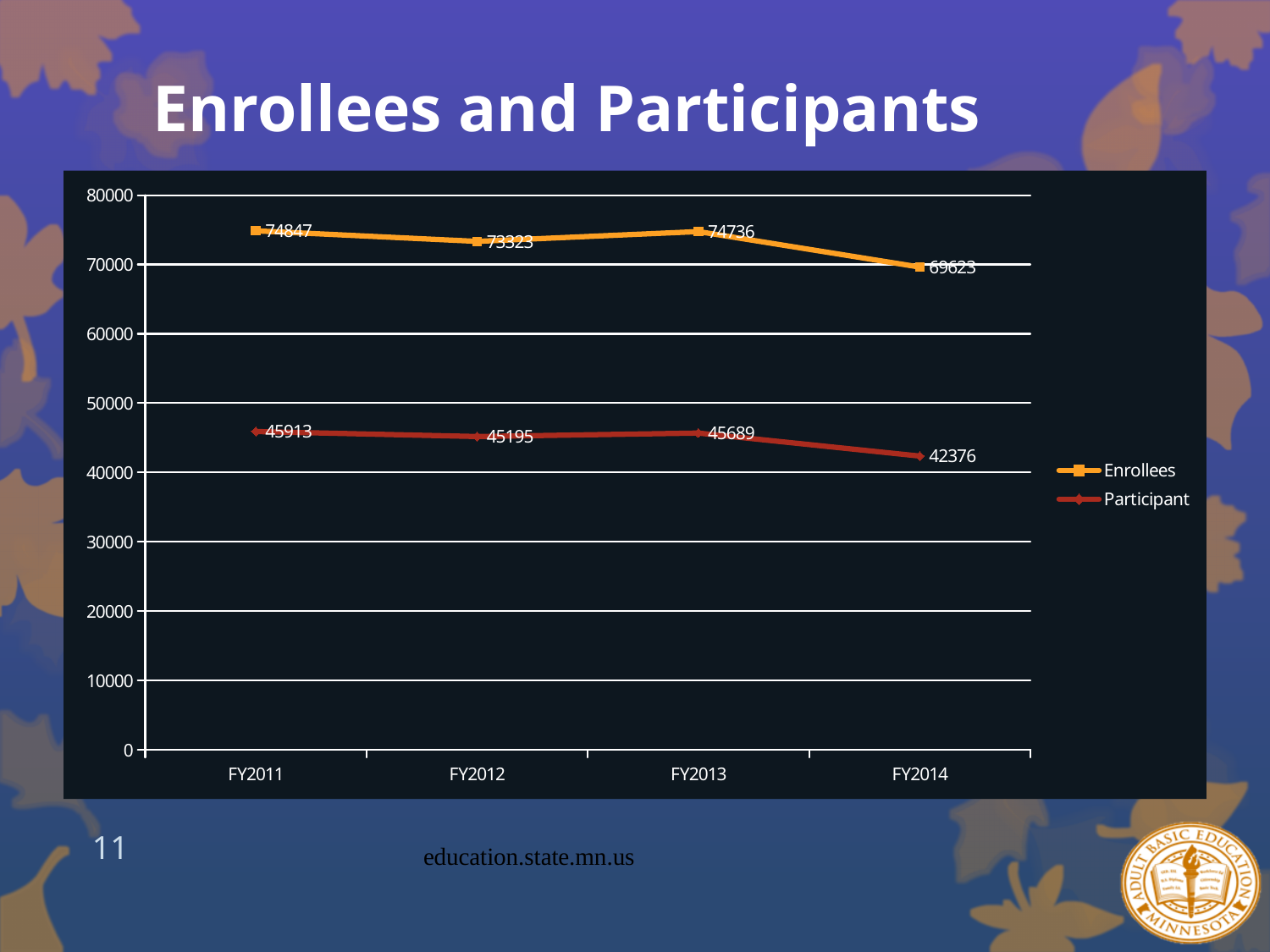
In which fiscal year is the Enrollees value highest? FY2011 What kind of chart is shown on the slide? line chart In which fiscal year is the Participant value lowest? FY2014 How many series does the legend list? 2 How many fiscal years are shown on the x axis? 4 What is the difference between the Enrollees and Participant values in FY2012? 28128 Is the Enrollees value for FY2014 greater or less than 70000? less Which is larger, the Participant value in FY2011 or in FY2013? FY2011 What is the Participant value for FY2014? 42376 What is the Enrollees value for FY2013? 74736 What is the Enrollees value for FY2011? 74847 By how much did the Enrollees value fall from FY2013 to FY2014? 5113